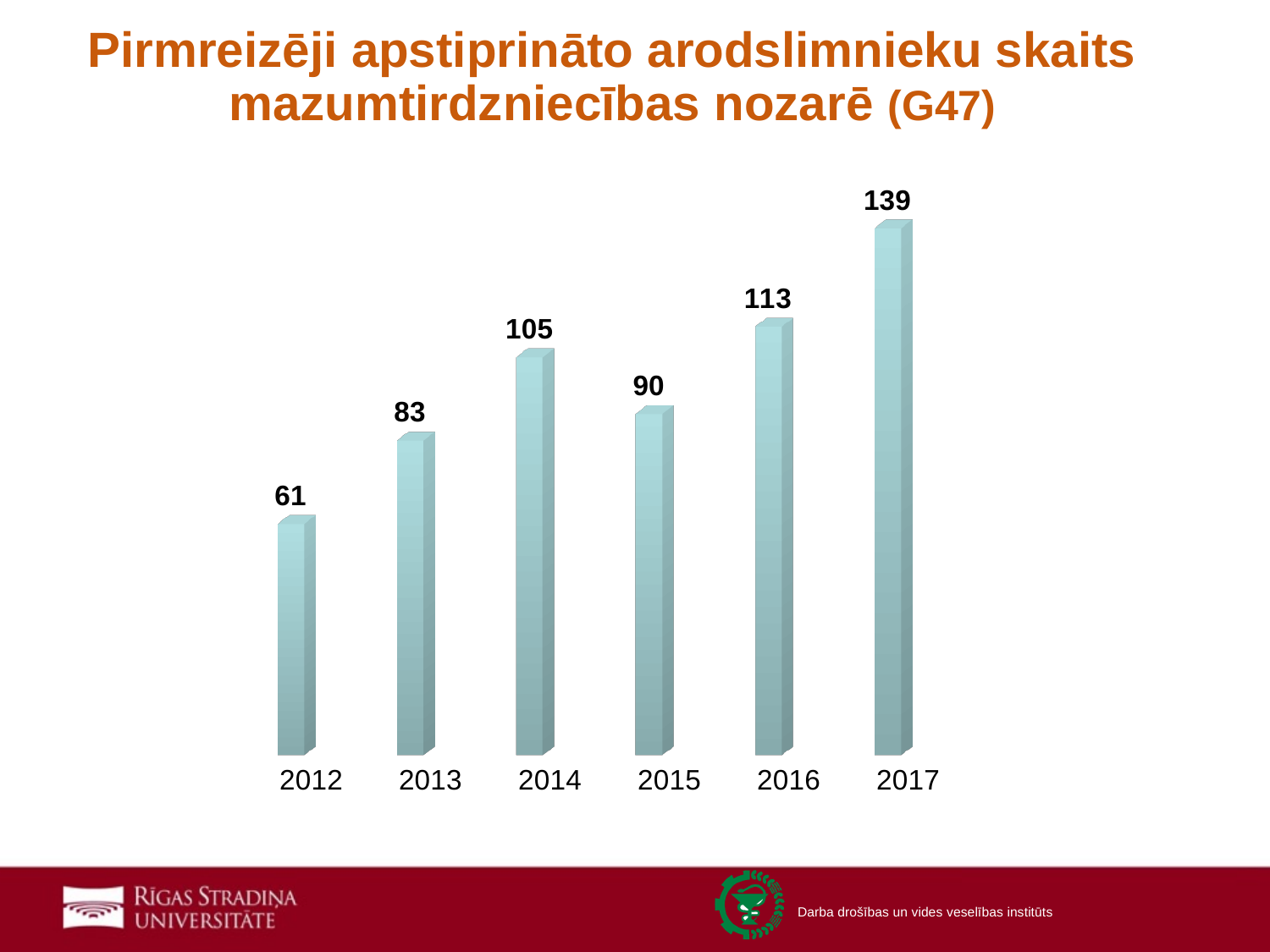
Which year has the lowest value? 2012 Which is larger, the value for 2014 or the value for 2015? 2014 Which year has the highest value? 2017 What is the title of the chart? Pirmreizēji apstiprināto arodslimnieku skaits mazumtirdzniecības nozarē (G47) What is the value for 2012? 61 Does the value rise or fall from 2012 to 2014? rise How many years are shown on the chart? 6 What kind of chart is shown on the slide? bar chart What is the difference between the values for 2017 and 2016? 26 What is the value for 2017? 139 What is the value for 2015? 90 What is the difference between the values for 2014 and 2015? 15